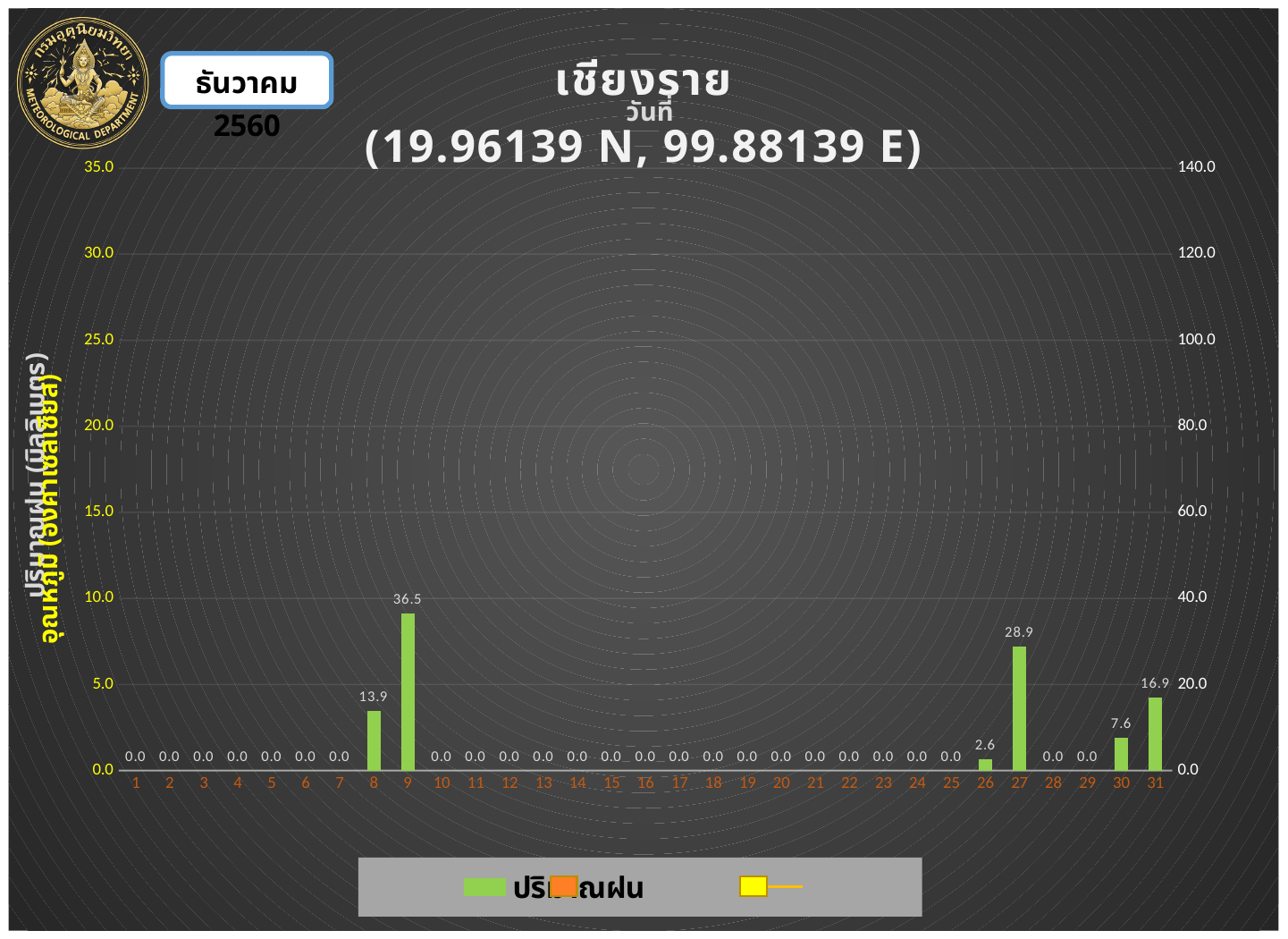
What are the coordinates shown in the chart title? 19.96139 N, 99.88139 E Which day has the highest rainfall value? 9 What is the rainfall value shown for day 31? 16.9 What is the rainfall value shown for day 8? 13.9 How many days (categories) are shown on the x axis? 31 What is the rainfall value shown for day 30? 7.6 What is the difference between the rainfall values for day 31 and day 8? 3.0 What is the difference between the rainfall values for day 9 and day 27? 7.6 What kind of chart is shown on the slide? bar chart What is the rainfall value shown for day 9? 36.5 Which is larger, the rainfall value for day 26 or for day 30? day 30 What is the rainfall value shown for day 27? 28.9